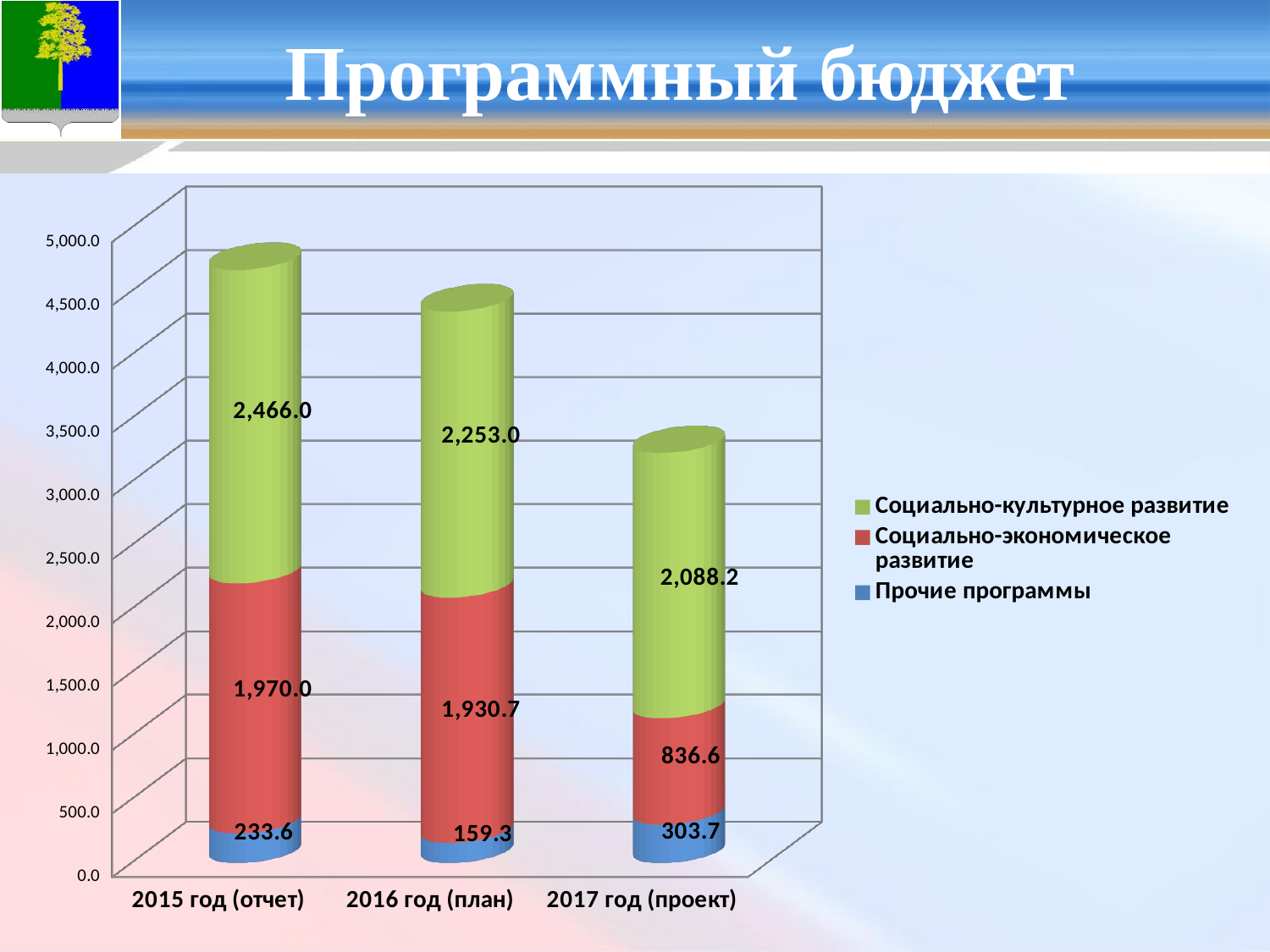
How many series does the legend list? 3 How many categories are shown on the x axis? 3 What is the value for Социально-культурное развитие in 2015 год (отчет)? 2,466.0 Does the Социально-культурное развитие value rise or fall from 2015 to 2017? fall Which is larger: Прочие программы in 2015 год (отчет) or in 2017 год (проект)? 2017 год (проект) What is the difference between the Социально-экономическое развитие values for 2016 год (план) and 2017 год (проект)? 1,094.1 What is the difference between the Социально-культурное развитие values for 2015 год (отчет) and 2017 год (проект)? 377.8 What is the value for Социально-экономическое развитие in 2016 год (план)? 1,930.7 Which year has the lowest value for Прочие программы? 2016 год (план) Which year has the highest value for Социально-экономическое развитие? 2015 год (отчет) What is the value for Прочие программы in 2017 год (проект)? 303.7 What is the total of the stacked bar for 2017 год (проект)? 3,228.5